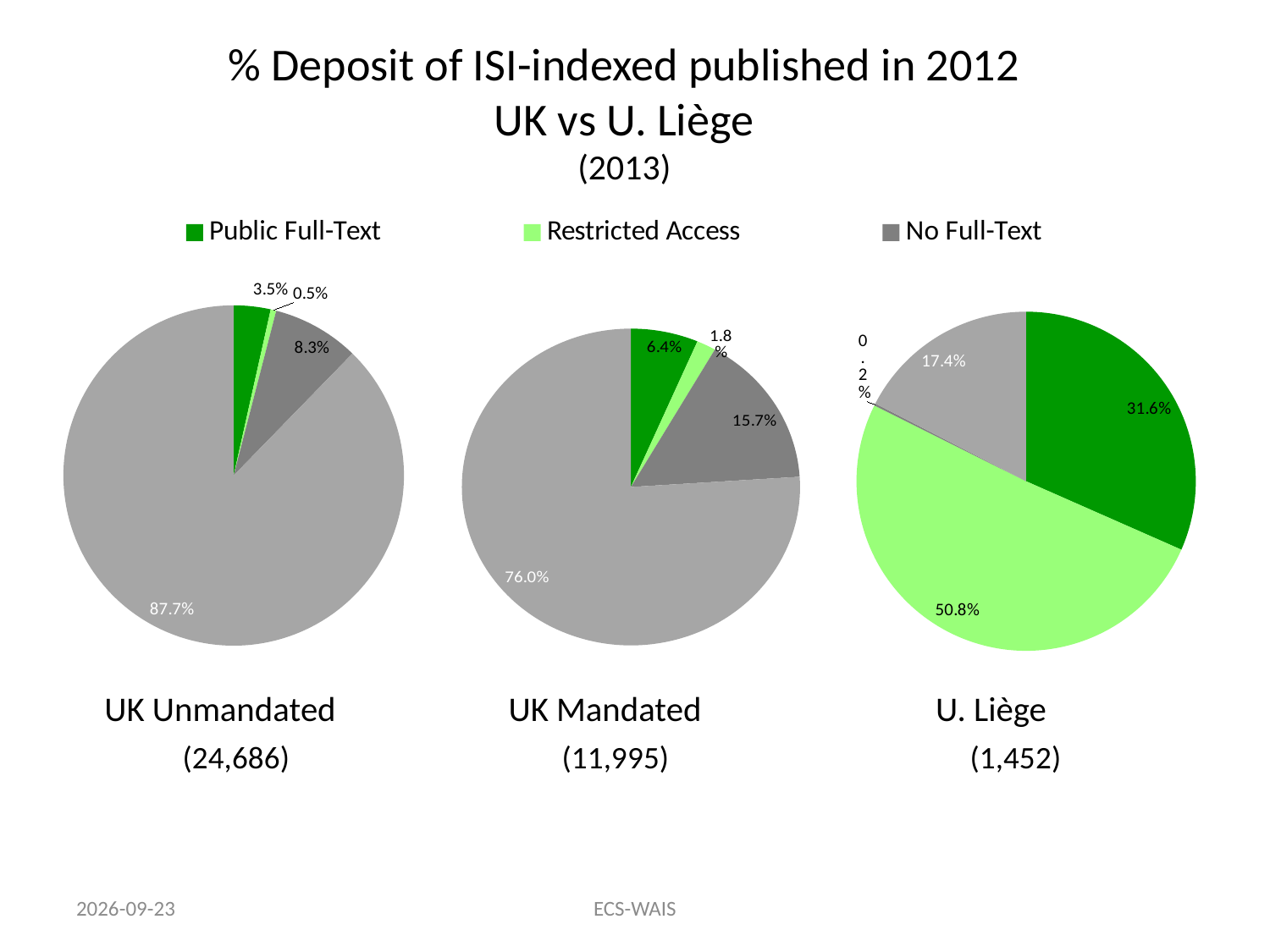
In the UK Mandated pie chart, what is the value for Public Full-Text? 6.4% How many series does the legend list? 3 In the UK Unmandated pie chart, what is the value for Restricted Access? 0.5% In the U. Liège pie chart, which series has the largest slice? Restricted Access In the UK Unmandated pie chart, what is the value of the largest slice? 87.7% What is the difference in percentage points between the Public Full-Text share in the UK Mandated pie chart and in the UK Unmandated pie chart? 2.9 In the U. Liège pie chart, what is the value for Public Full-Text? 31.6% In the UK Unmandated pie chart, what is the value for Public Full-Text? 3.5% What kind of chart is used on this slide? pie chart How many pie charts are shown on the slide? 3 In the U. Liège pie chart, what is the value for Restricted Access? 50.8% Is the Public Full-Text share larger in the UK Mandated pie chart or the UK Unmandated pie chart? UK Mandated